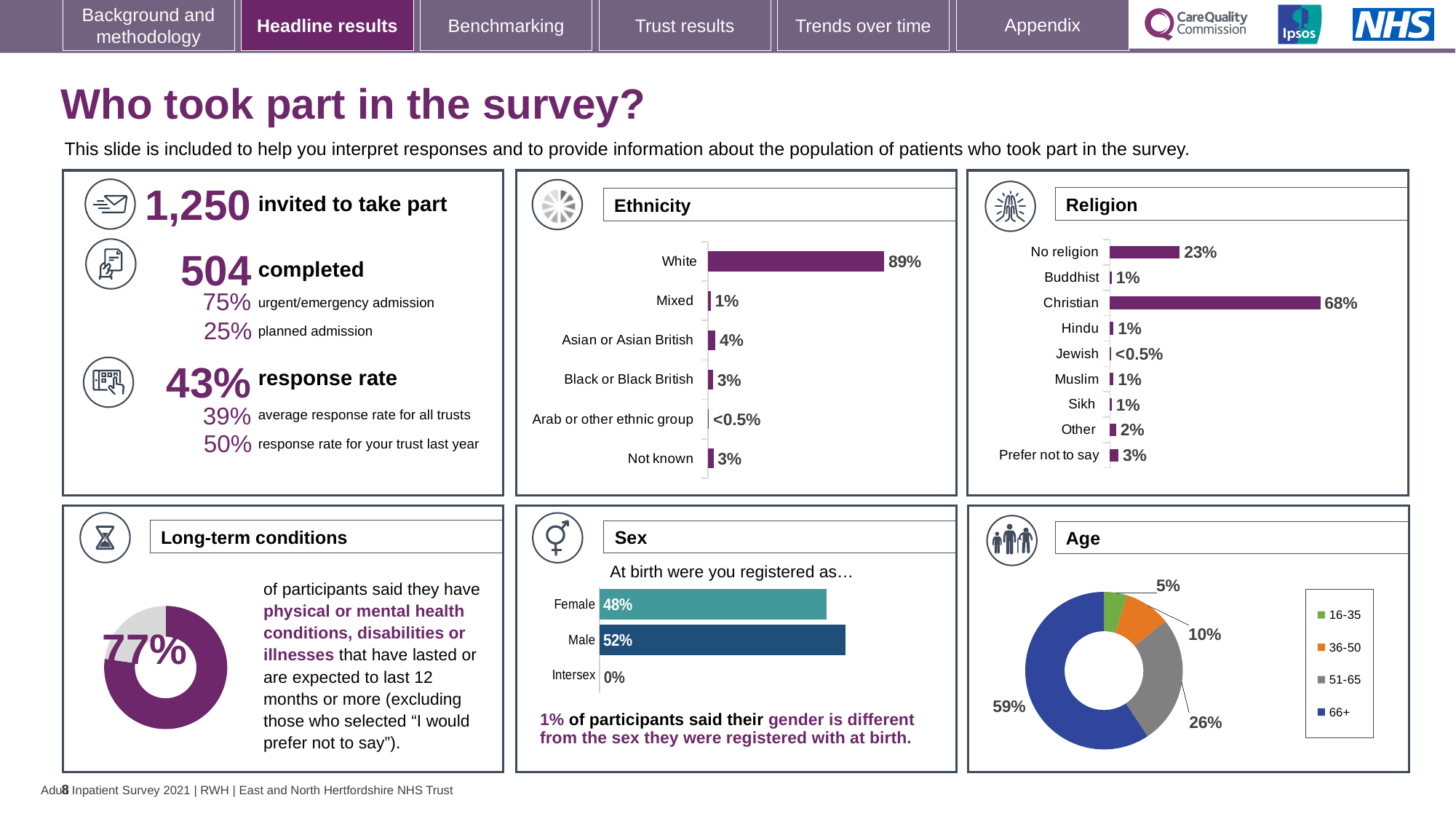
In the Religion chart, which category has the second highest value? No religion In the Religion chart, what percentage of participants were Christian? 68% In the Ethnicity chart, what percentage of participants were White? 89% In the Age chart, what share of participants were aged 66+? 59% In the Ethnicity chart, what is the difference between the values for Asian or Asian British and Black or Black British? 1% In the Age chart, how many age groups does the legend list? 4 In the Religion chart, what is the difference between the values for Christian and No religion? 45% In the Ethnicity chart, which category has the highest value? White In the Sex chart, which is larger, the value for Female or the value for Male? Male In the Religion chart, how many categories are shown? 9 In the Ethnicity chart, how many categories are shown? 6 In the Sex chart, what percentage of participants were registered as Intersex at birth? 0%